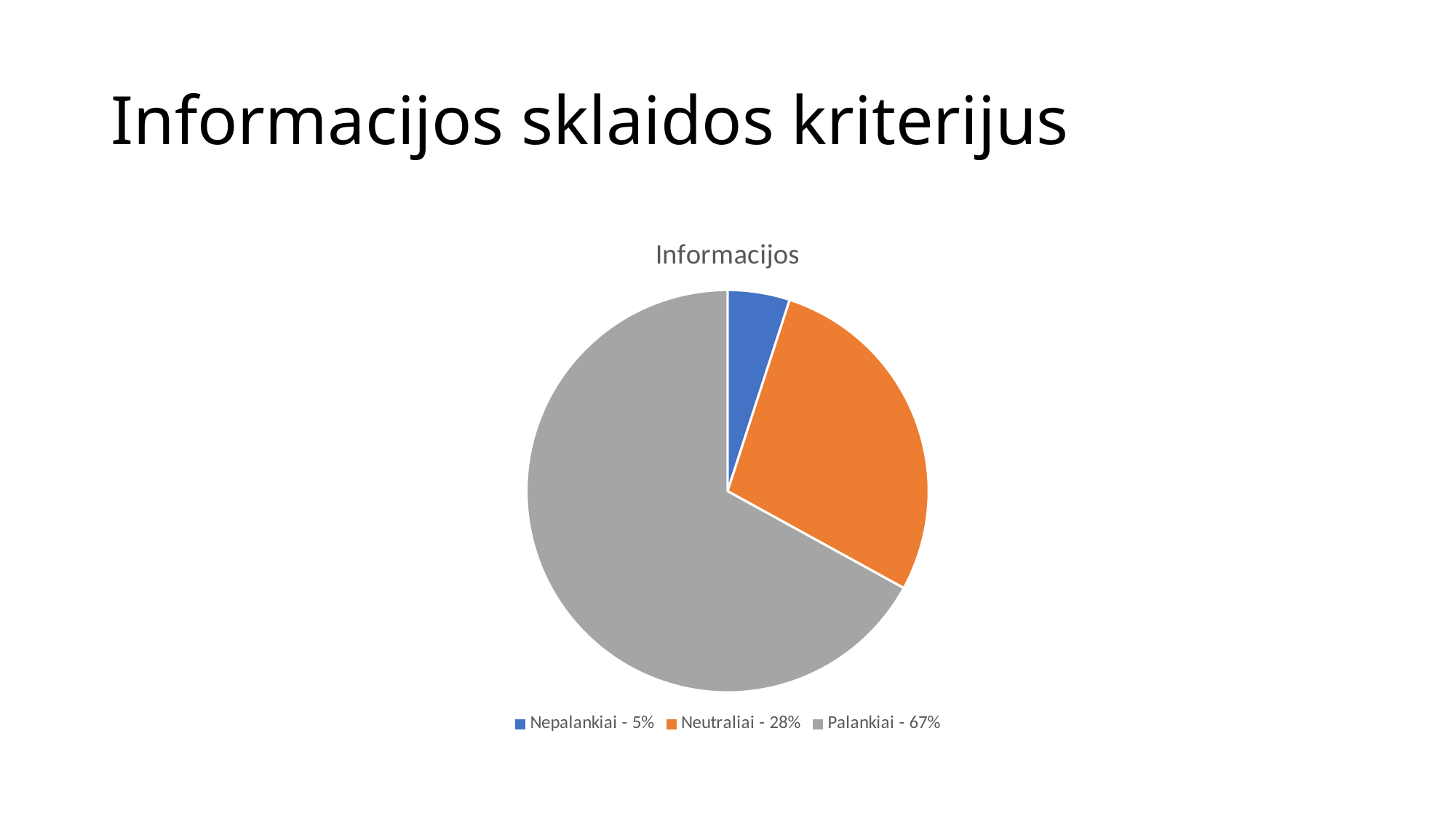
What share of the pie is Palankiai? 67% Which is larger, Neutraliai or Nepalankiai? Neutraliai What share of the pie is Neutraliai? 28% What is the title of the chart? Informacijos What is the difference between the Palankiai and Neutraliai shares? 39% Which category has the largest slice? Palankiai What is the difference between the Neutraliai and Nepalankiai shares? 23% What share of the pie is Nepalankiai? 5% What kind of chart is shown on the slide? pie chart Which category has the smallest slice? Nepalankiai What colour is the Palankiai slice? grey How many slices does the pie chart have? 3